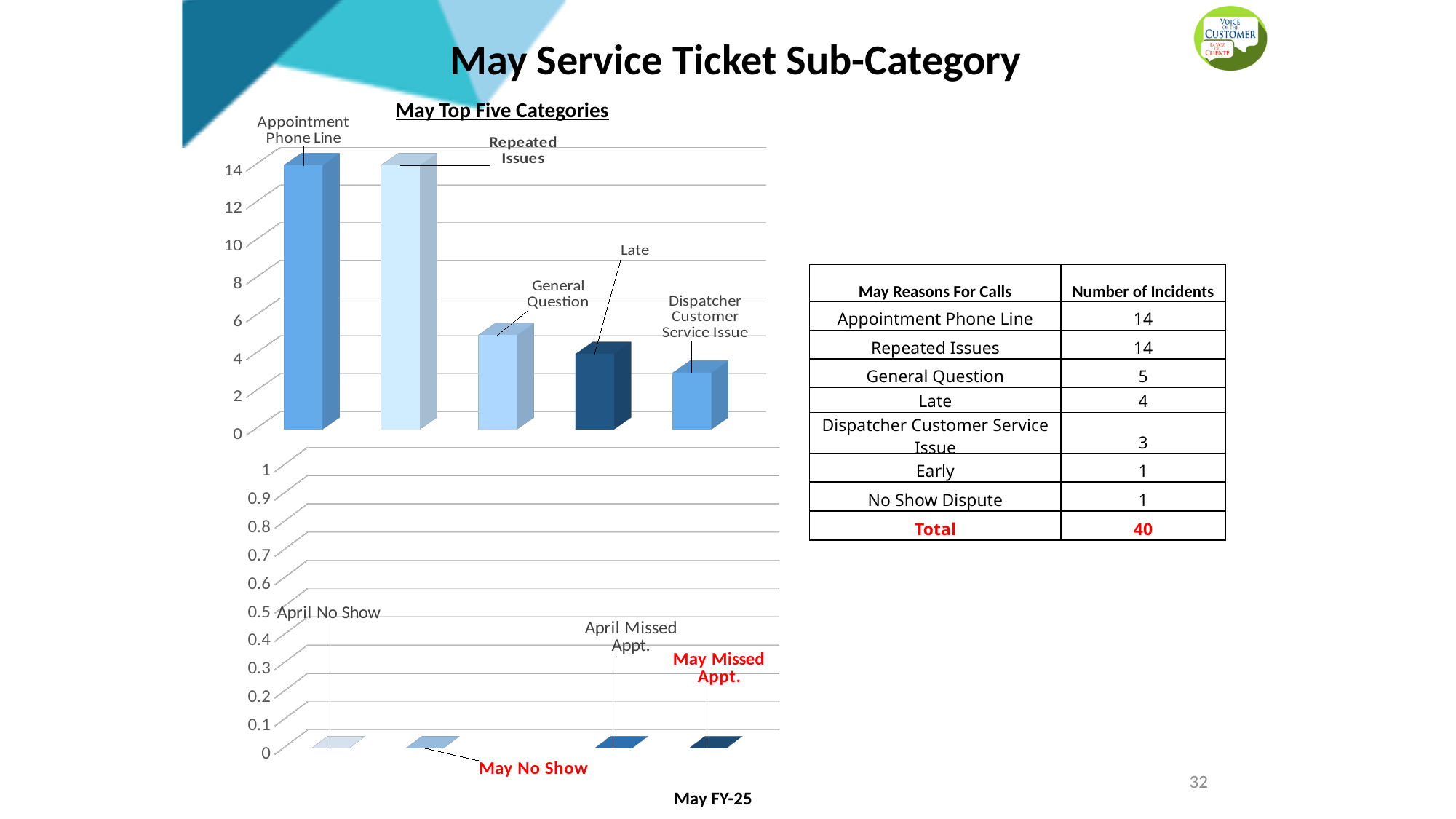
In the 'May Top Five Categories' chart, is the value for General Question greater or less than 4? greater In the 'May Top Five Categories' chart, what is the value for Repeated Issues? 14 How many categories are plotted in the bottom chart (April No Show, May No Show, April Missed Appt., May Missed Appt.)? 4 In the 'May Top Five Categories' chart, which is larger, General Question or Late? General Question What kind of chart is the 'May Top Five Categories' chart? bar chart In the 'May Top Five Categories' chart, is the value for Dispatcher Customer Service Issue greater or less than 4? less In the 'May Top Five Categories' chart, do the values rise or fall from left to right? fall In the 'May Top Five Categories' chart, what is the value for Appointment Phone Line? 14 In the bottom chart, what is the value for May No Show? 0 How many categories are plotted in the 'May Top Five Categories' chart? 5 In the 'May Top Five Categories' chart, which category has the lowest value? Dispatcher Customer Service Issue In the 'May Top Five Categories' chart, what is the value for Late? 4